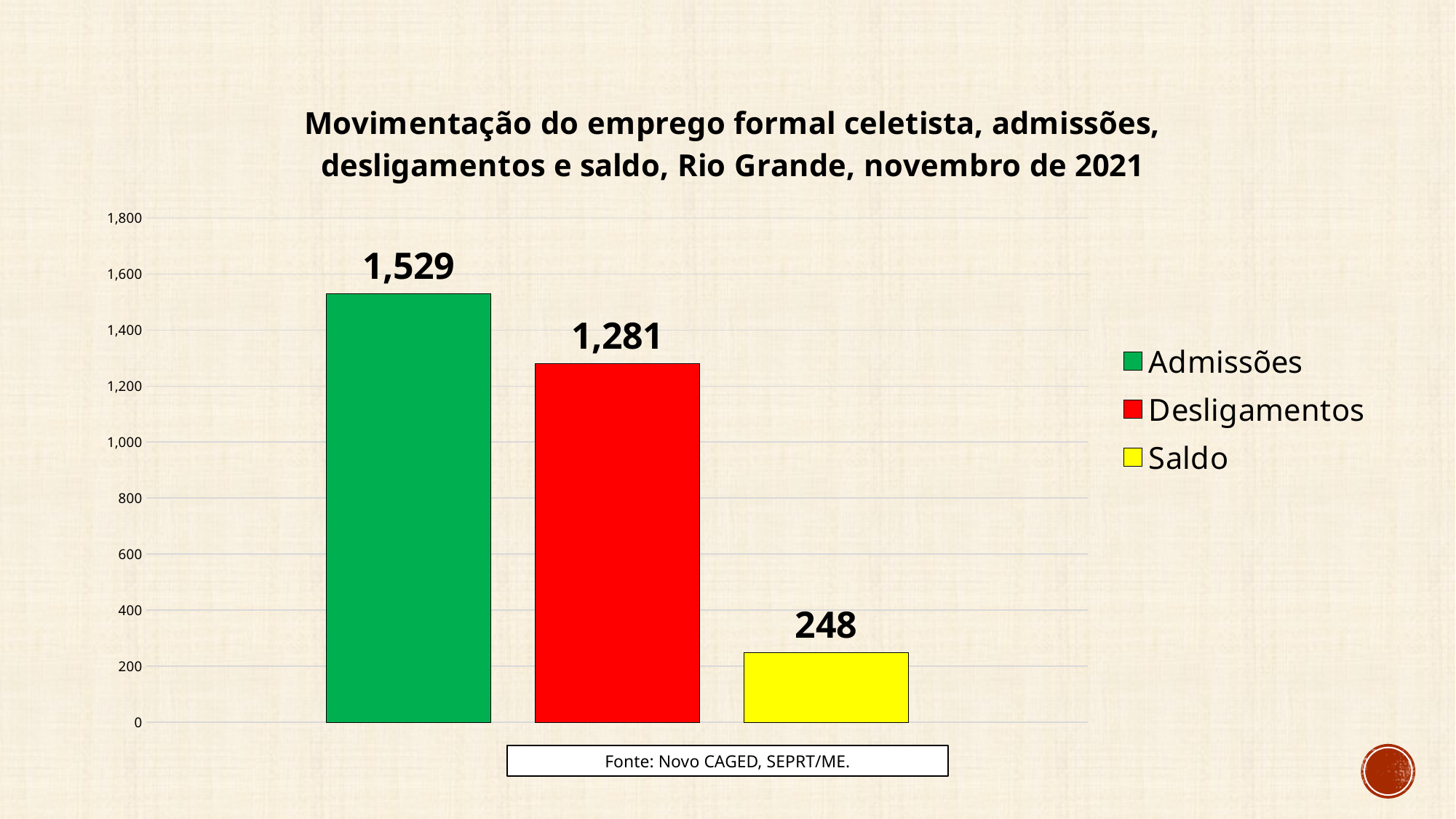
How many series does the legend list? 3 What kind of chart is shown on the slide? Bar chart How many bars are plotted in the chart? 3 Which series has the highest value? Admissões What is the value for Desligamentos? 1,281 What is the value for Admissões? 1,529 What is the value for Saldo? 248 What colour is the bar for Saldo? Yellow Which series has the lowest value? Saldo Is the value for Desligamentos greater or less than 1,200? greater What is the difference between Admissões and Desligamentos? 248 Which is larger, Desligamentos or Saldo? Desligamentos